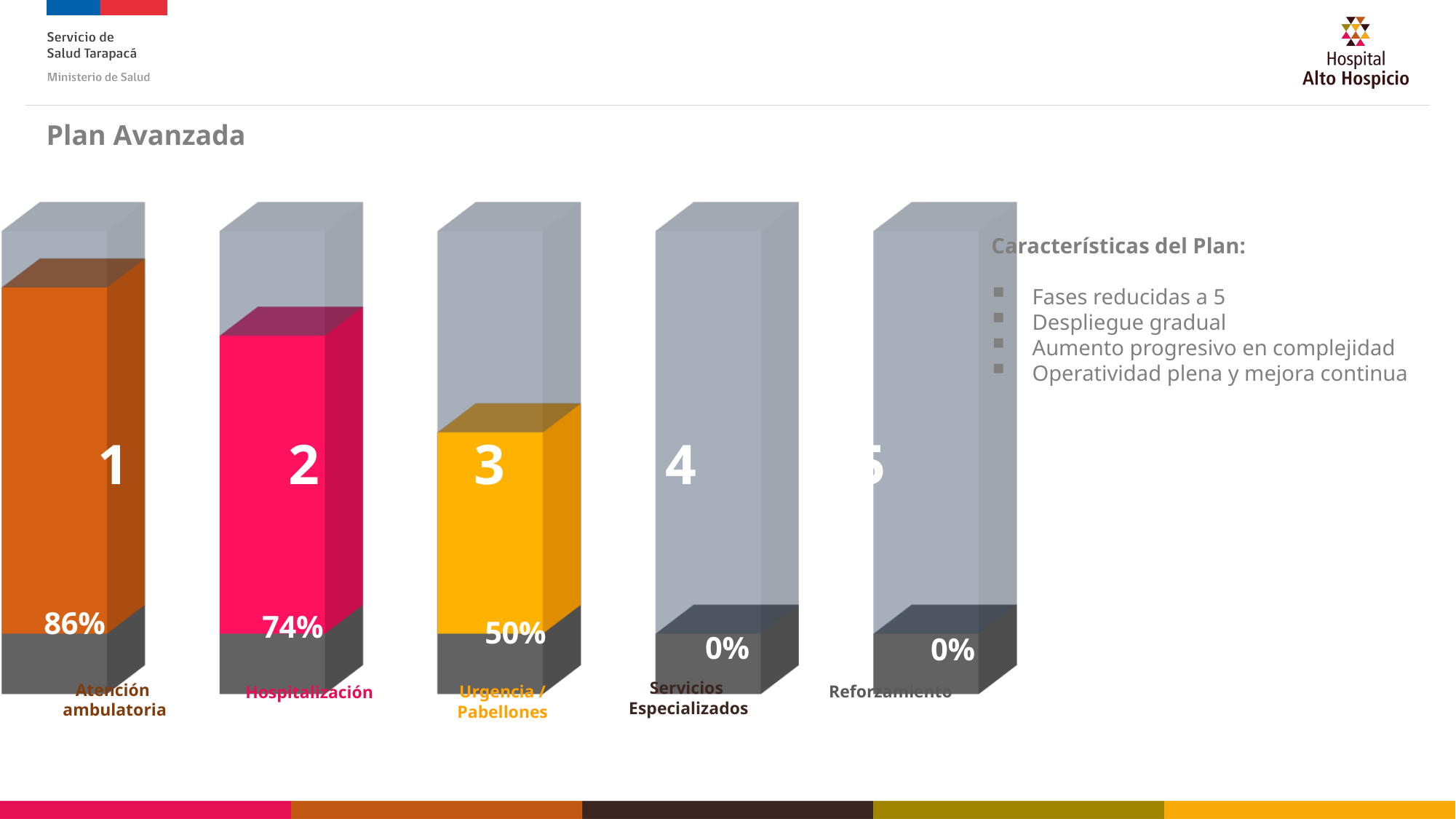
Which is larger, the value for Hospitalización or the value for Urgencia / Pabellones? Hospitalización What is the difference between the values for Atención ambulatoria and Hospitalización? 12% What is the difference between the values for Hospitalización and Urgencia / Pabellones? 24% How many phases (bars) are shown in the chart? 5 What is the value shown for Reforzamiento? 0% What is the value shown for Servicios Especializados? 0% What kind of chart is shown on the slide? Bar chart What is the value shown for Atención ambulatoria? 86% Do the values rise or fall from phase 1 to phase 5? Fall What is the value shown for Hospitalización? 74% Which phase has the highest value? Atención ambulatoria What is the value shown for Urgencia / Pabellones? 50%